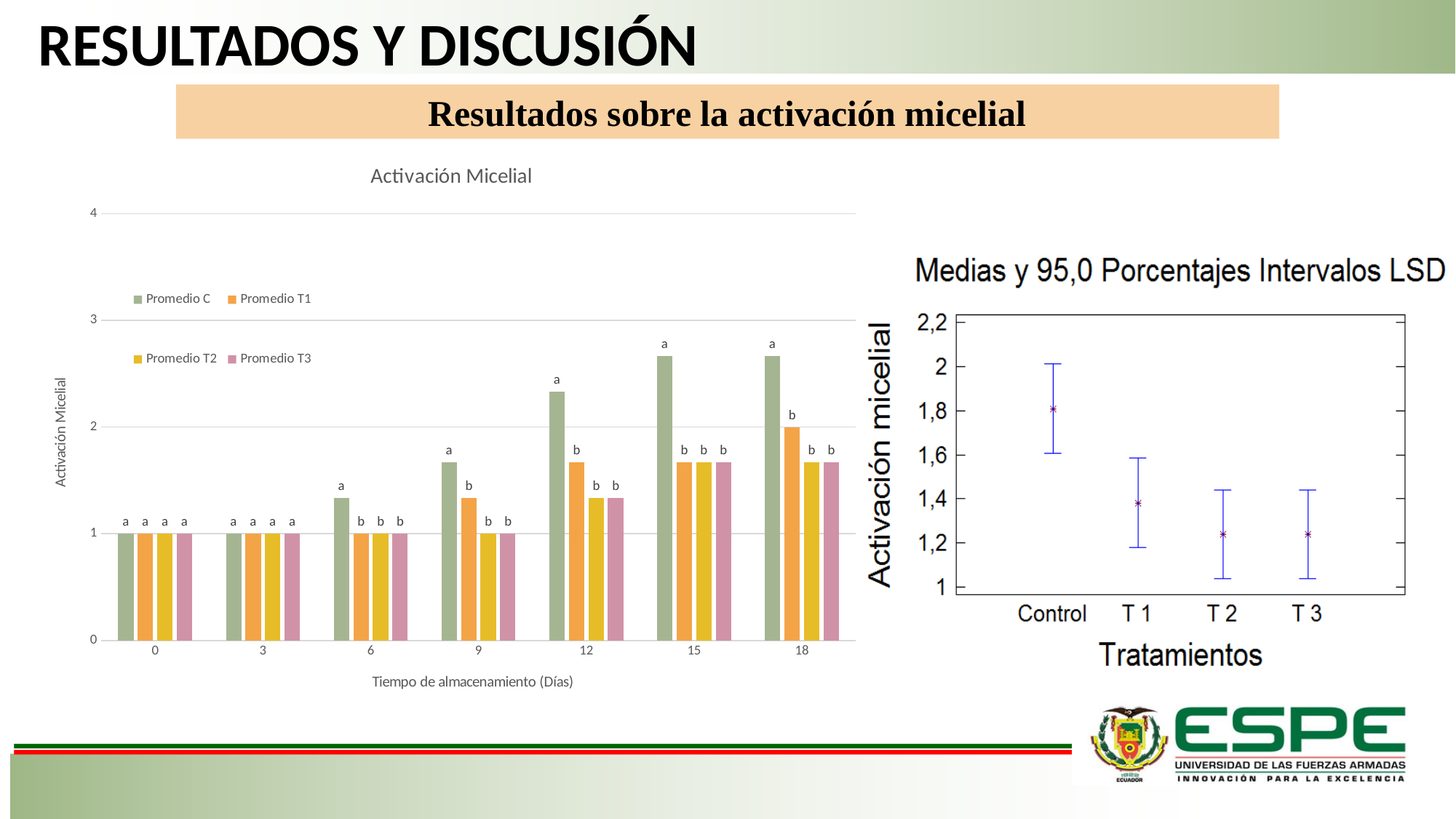
In the 'Activación Micelial' bar chart, what is the value of Promedio C at day 0? 1 In the 'Medias y 95,0 Porcentajes Intervalos LSD' chart on the right, which treatment has the highest mean? Control In the 'Activación Micelial' bar chart, what is the value of Promedio T1 at day 18? 2 What kind of chart is the 'Activación Micelial' chart on the left? bar chart In the 'Activación Micelial' bar chart, does Promedio C rise or fall from day 0 to day 18? rise In the 'Activación Micelial' bar chart, is the value for Promedio C at day 15 greater or less than 2? greater In the 'Activación Micelial' bar chart, how many series does the legend list? 4 In the 'Activación Micelial' bar chart, which series has the highest value at day 12? Promedio C In the 'Activación Micelial' bar chart, how many storage-time categories are shown on the x axis? 7 In the 'Activación Micelial' bar chart, is the value for Promedio T1 at day 12 greater or less than 2? less In the 'Medias y 95,0 Porcentajes Intervalos LSD' chart on the right, is the mean for Control greater or less than 1,6? greater In the 'Activación Micelial' bar chart, at day 9, which is larger: Promedio C or Promedio T1? Promedio C